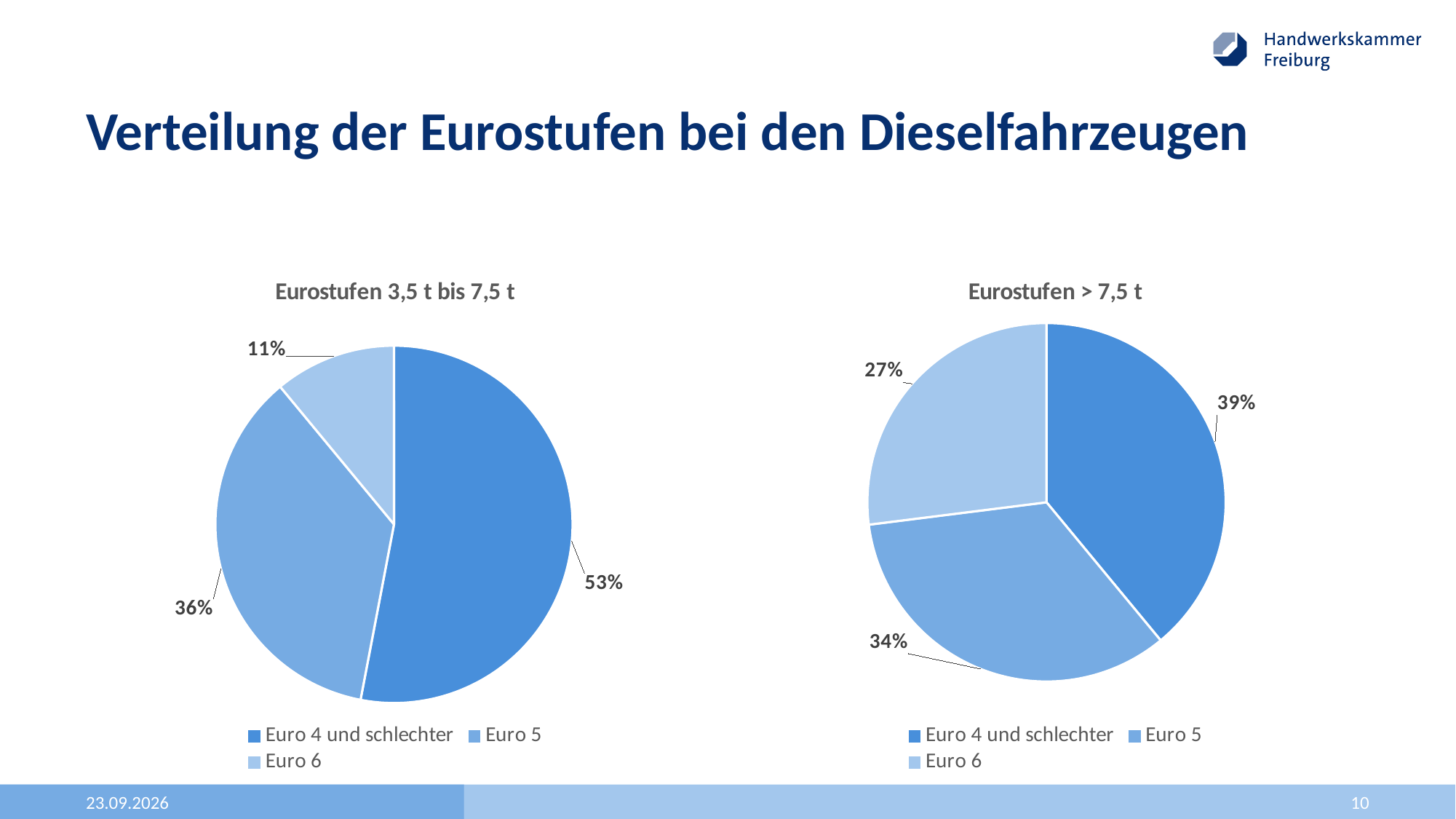
What is the title of the chart on the left side of the slide? Eurostufen 3,5 t bis 7,5 t In the chart titled "Eurostufen > 7,5 t", what share does Euro 5 have? 34% In the chart titled "Eurostufen > 7,5 t", which category has the smallest slice? Euro 6 In the chart titled "Eurostufen 3,5 t bis 7,5 t", what is the difference in percentage points between Euro 4 und schlechter and Euro 5? 17 In the chart titled "Eurostufen 3,5 t bis 7,5 t", what share does Euro 6 have? 11% In the chart titled "Eurostufen > 7,5 t", what share does Euro 6 have? 27% How many slices does the chart titled "Eurostufen > 7,5 t" have? 3 In the chart titled "Eurostufen > 7,5 t", which is larger: Euro 4 und schlechter or Euro 5? Euro 4 und schlechter What kind of chart is the chart titled "Eurostufen 3,5 t bis 7,5 t"? Pie chart In the chart titled "Eurostufen 3,5 t bis 7,5 t", what share does Euro 4 und schlechter have? 53% Which category has a larger share in the chart titled "Eurostufen > 7,5 t" than in the chart titled "Eurostufen 3,5 t bis 7,5 t": Euro 6 or Euro 4 und schlechter? Euro 6 In the chart titled "Eurostufen 3,5 t bis 7,5 t", which category has the largest slice? Euro 4 und schlechter